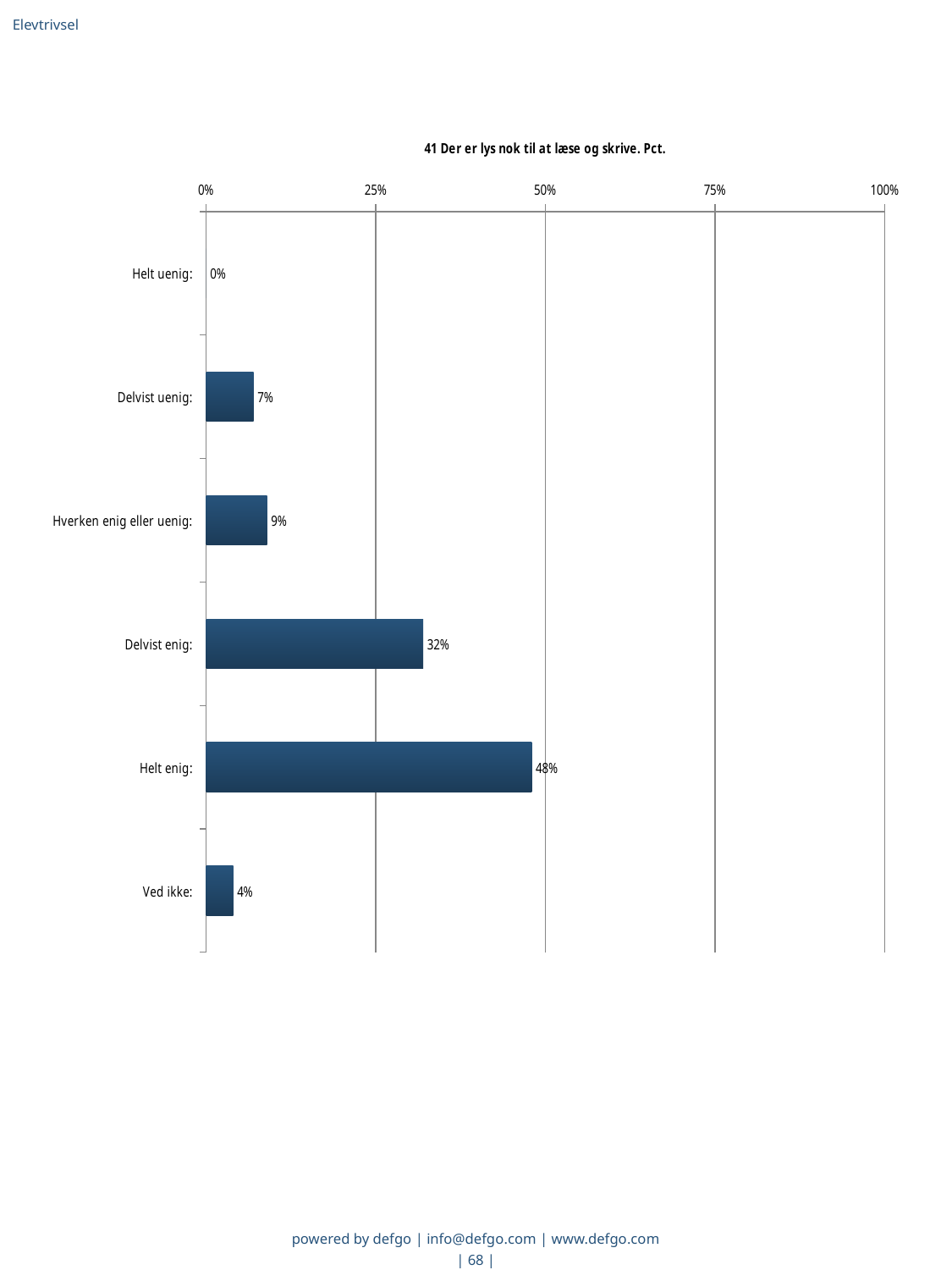
What is the value for "Delvist enig"? 32% How many categories are shown on the chart? 6 Is the value for "Helt enig" greater or less than 50%? less Which category has the lowest value? Helt uenig What is the title of the chart? 41 Der er lys nok til at læse og skrive. Pct. Which category has the highest value? Helt enig What is the value for "Ved ikke"? 4% What kind of chart is shown on the slide? bar chart What is the value for "Helt enig"? 48% What is the value for "Hverken enig eller uenig"? 9% Which is larger, the value for "Delvist uenig" or the value for "Hverken enig eller uenig"? Hverken enig eller uenig What is the difference between the values for "Helt enig" and "Delvist enig"? 16%